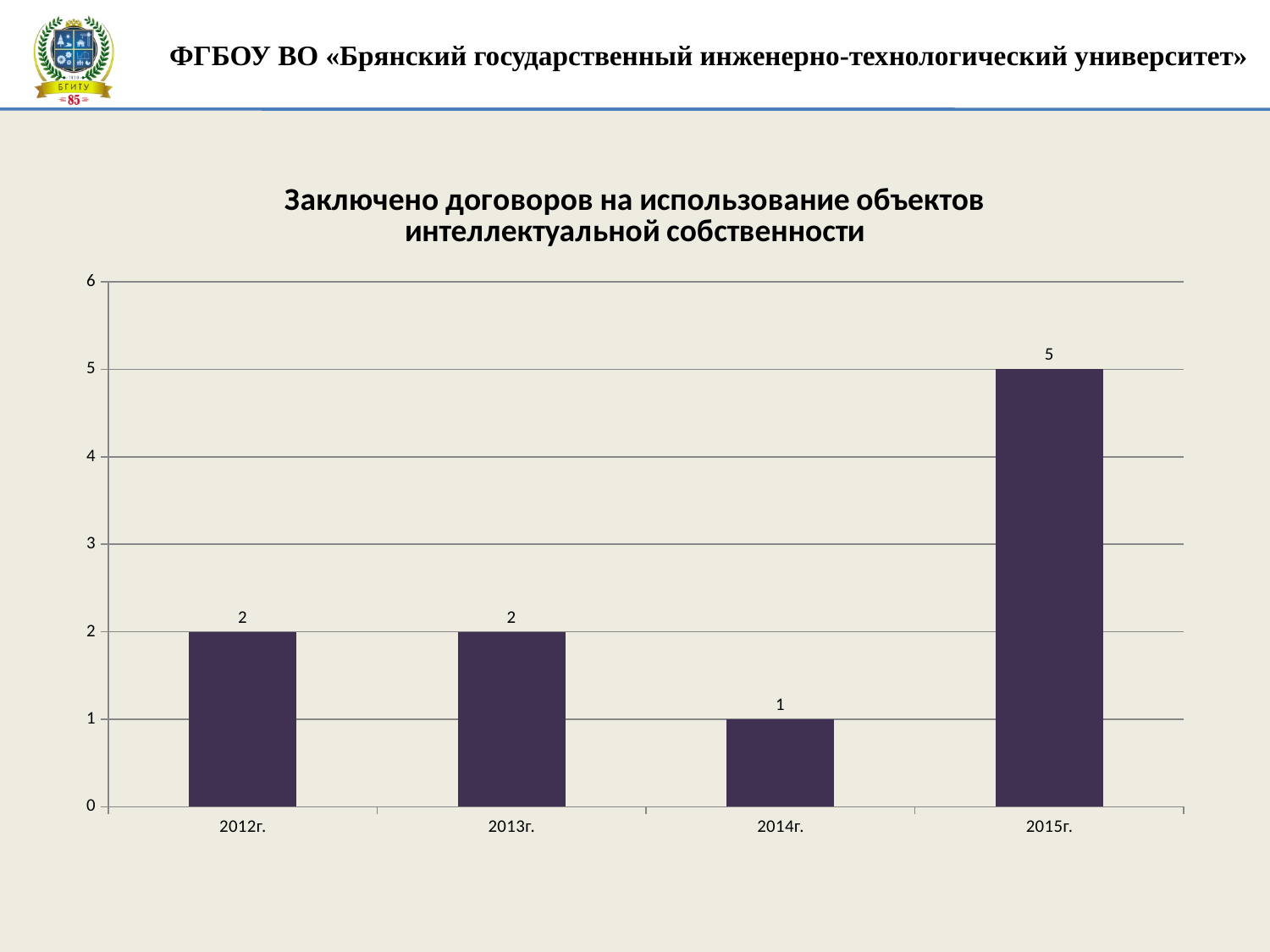
What is the difference between the values for 2015г. and 2014г.? 4 What is the value for 2012г.? 2 How many years are shown on the x axis? 4 What is the value for 2014г.? 1 What is the title of the chart? Заключено договоров на использование объектов интеллектуальной собственности What is the difference between the values for 2015г. and 2013г.? 3 What is the value for 2015г.? 5 Which year has the lowest value? 2014г. Is the value for 2015г. greater or less than 4? greater What kind of chart is shown on the slide? bar chart Which year has the highest value? 2015г. Which is larger, the value for 2013г. or the value for 2014г.? 2013г.